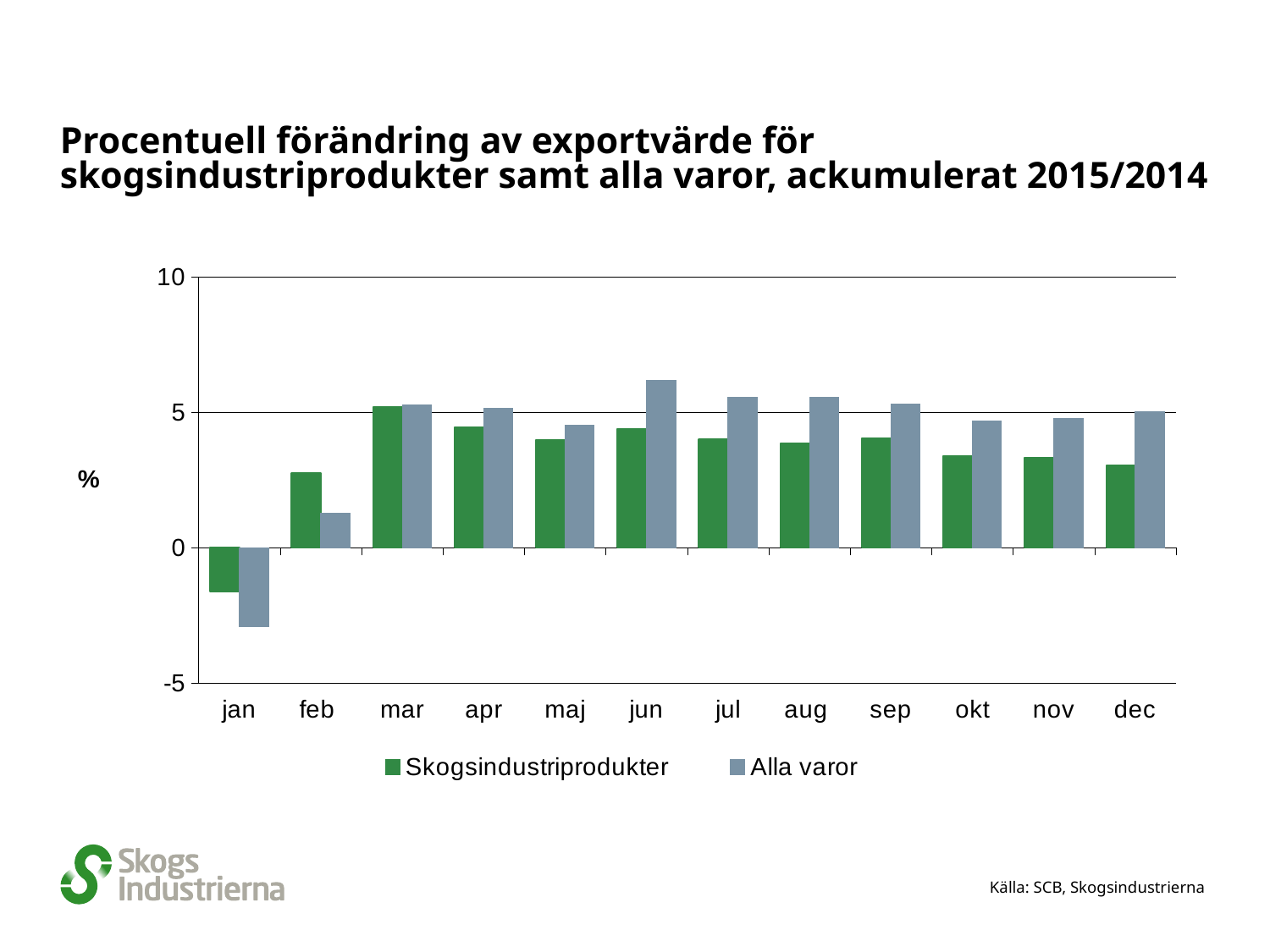
How many series does the legend list? 2 How many months are shown on the x axis? 12 Is the value for Skogsindustriprodukter in jan greater or less than 0? less What kind of chart is shown on the slide? bar chart In jul, which series has the larger value, Skogsindustriprodukter or Alla varor? Alla varor Which month has the highest value for Skogsindustriprodukter? mar Is the value for Alla varor in feb greater or less than 5? less Is the value for Alla varor in jun greater or less than 5? greater In feb, which series has the larger value, Skogsindustriprodukter or Alla varor? Skogsindustriprodukter Which month has the lowest value for Alla varor? jan What label is shown on the vertical axis? % Which month has the highest value for Alla varor? jun